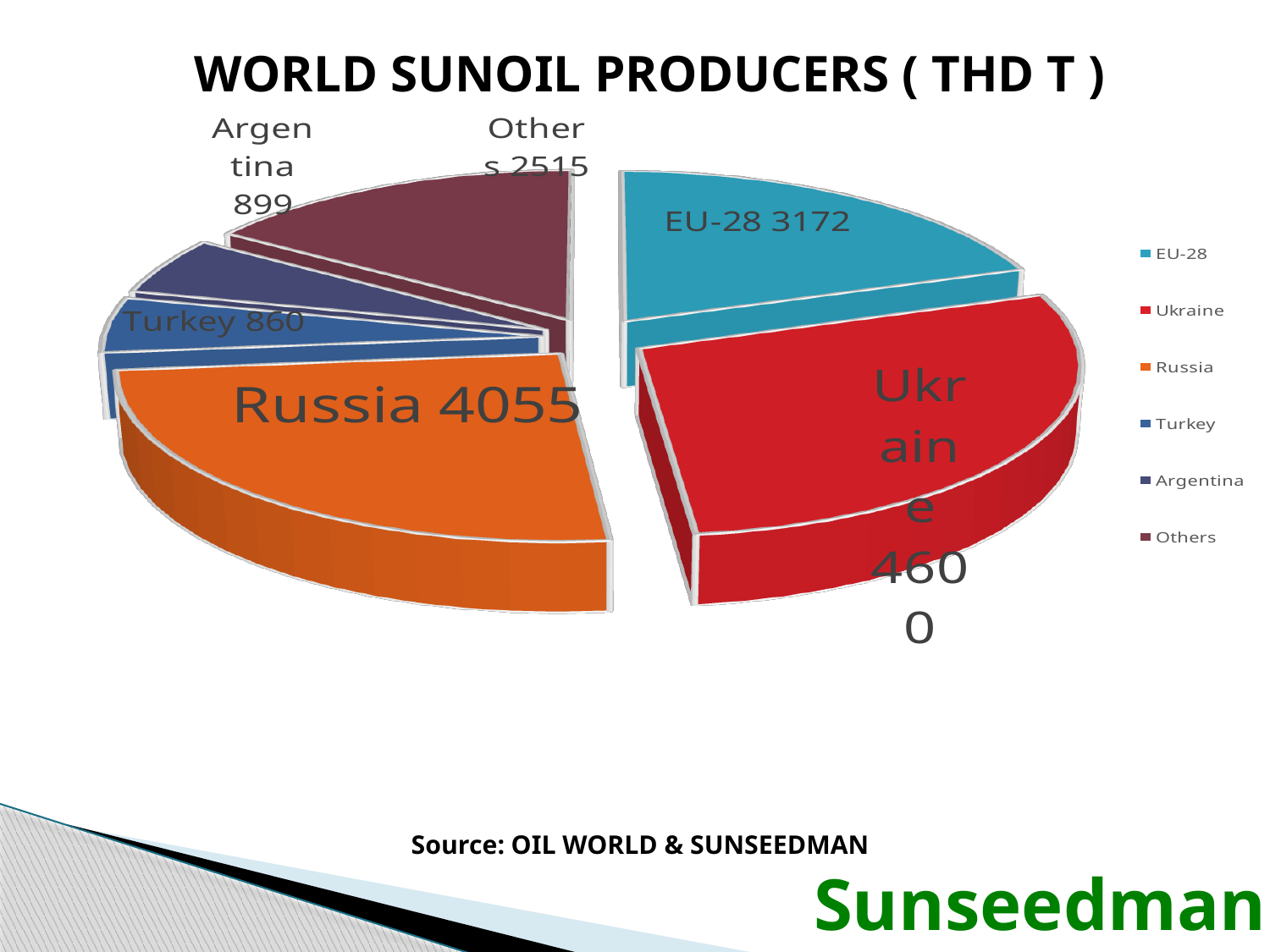
Which producer has the highest value? Ukraine What is the difference between the values for Ukraine and Russia? 545 What kind of chart is shown on the slide? Pie chart Which is larger, the value for EU-28 or the value for Others? EU-28 What is the title of the chart? WORLD SUNOIL PRODUCERS ( THD T ) Which producer has the lowest value? Turkey What is the value for Argentina? 899 What is the value for Turkey? 860 How many producer categories are shown in the pie chart? 6 What is the value for Others? 2515 What is the value for Russia? 4055 What is the value for EU-28? 3172